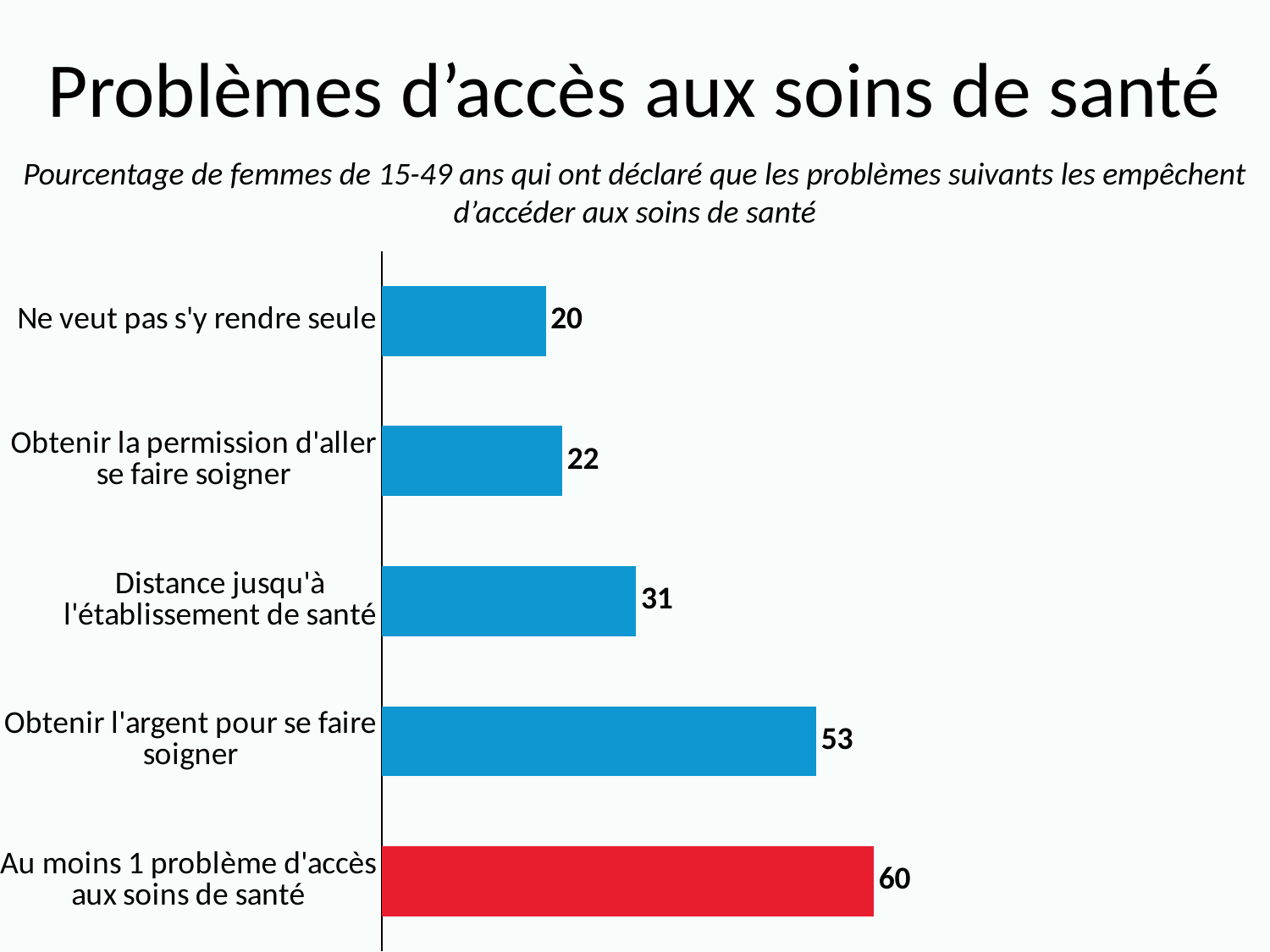
What is the value for "Ne veut pas s'y rendre seule"? 20 What is the value for "Obtenir l'argent pour se faire soigner"? 53 Which bar is shown in red rather than blue? Au moins 1 problème d'accès aux soins de santé Which category has the highest value? Au moins 1 problème d'accès aux soins de santé What is the value for "Obtenir la permission d'aller se faire soigner"? 22 What is the difference between the values for "Obtenir l'argent pour se faire soigner" and "Distance jusqu'à l'établissement de santé"? 22 What is the value for "Distance jusqu'à l'établissement de santé"? 31 How many categories are shown in the chart? 5 Which category has the lowest value? Ne veut pas s'y rendre seule What is the value for "Au moins 1 problème d'accès aux soins de santé"? 60 What kind of chart is shown on the slide? Bar chart Which is larger: the value for "Obtenir la permission d'aller se faire soigner" or the value for "Ne veut pas s'y rendre seule"? Obtenir la permission d'aller se faire soigner